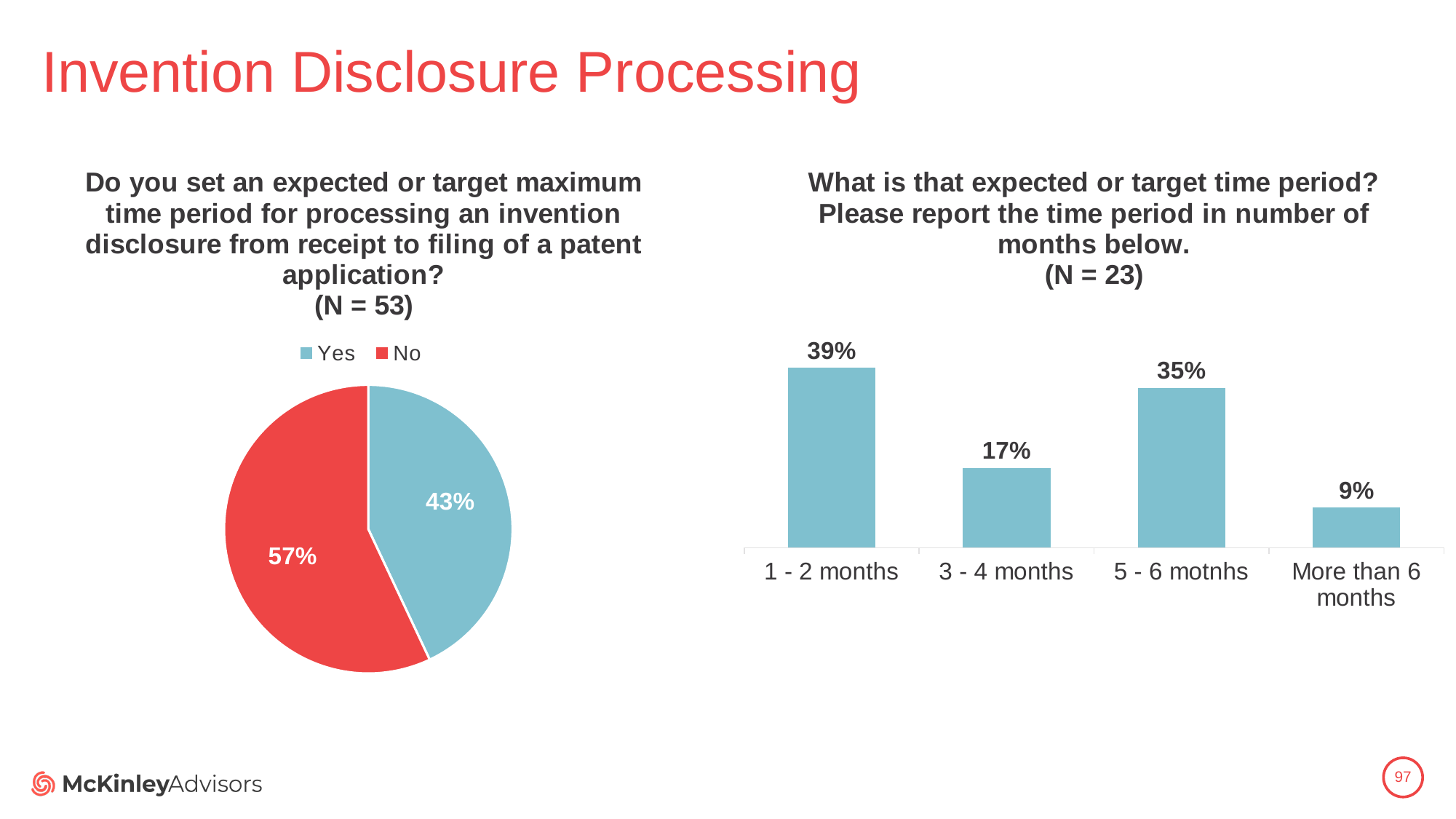
In the bar chart on the right, what is the value for 1 - 2 months? 39% In the bar chart on the right, which category has the highest value? 1 - 2 months What kind of chart is the chart on the right? Bar chart In the bar chart on the right, how many categories are shown? 4 What kind of chart is the chart on the left? Pie chart In the bar chart on the right, what is the value for More than 6 months? 9% In the pie chart on the left, what share of respondents answered No? 57% In the pie chart on the left, how many entries does the legend list? 2 In the bar chart on the right, what is the difference between the values for 1 - 2 months and 3 - 4 months? 22% In the pie chart on the left, what share of respondents answered Yes? 43% In the pie chart on the left, which answer has the larger share, Yes or No? No In the bar chart on the right, which category has the lowest value? More than 6 months